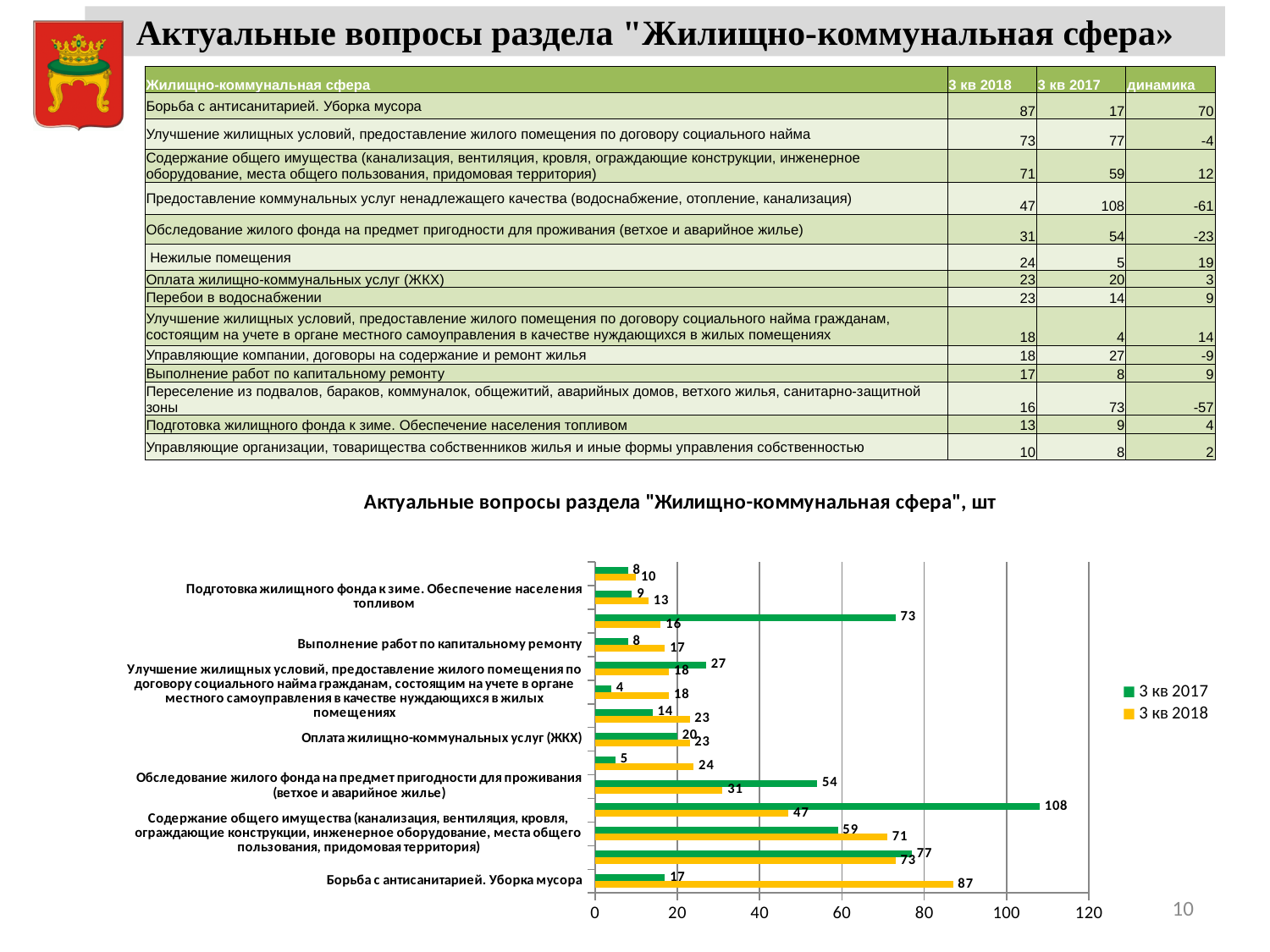
What is the title of the chart? Актуальные вопросы раздела "Жилищно-коммунальная сфера", шт What is the value for "Оплата жилищно-коммунальных услуг (ЖКХ)" in the 3 кв 2017 series? 20 What is the difference between the 3 кв 2017 and 3 кв 2018 values for "Обследование жилого фонда на предмет пригодности для проживания (ветхое и аварийное жилье)"? 23 What is the value for "Выполнение работ по капитальному ремонту" in the 3 кв 2018 series? 17 What type of chart is shown on the slide? bar chart What is the value for "Борьба с антисанитарией. Уборка мусора" in the 3 кв 2018 series? 87 What is the value for "Борьба с антисанитарией. Уборка мусора" in the 3 кв 2017 series? 17 How many series does the chart legend list? 2 What is the value for "Обследование жилого фонда на предмет пригодности для проживания (ветхое и аварийное жилье)" in the 3 кв 2017 series? 54 What is the difference between the 3 кв 2018 and 3 кв 2017 values for "Подготовка жилищного фонда к зиме. Обеспечение населения топливом"? 4 Which category has the highest value in the 3 кв 2018 series? Борьба с антисанитарией. Уборка мусора For "Содержание общего имущества (канализация, вентиляция, кровля, ограждающие конструкции, инженерное оборудование, места общего пользования, придомовая территория)", which series has the larger value, 3 кв 2017 or 3 кв 2018? 3 кв 2018